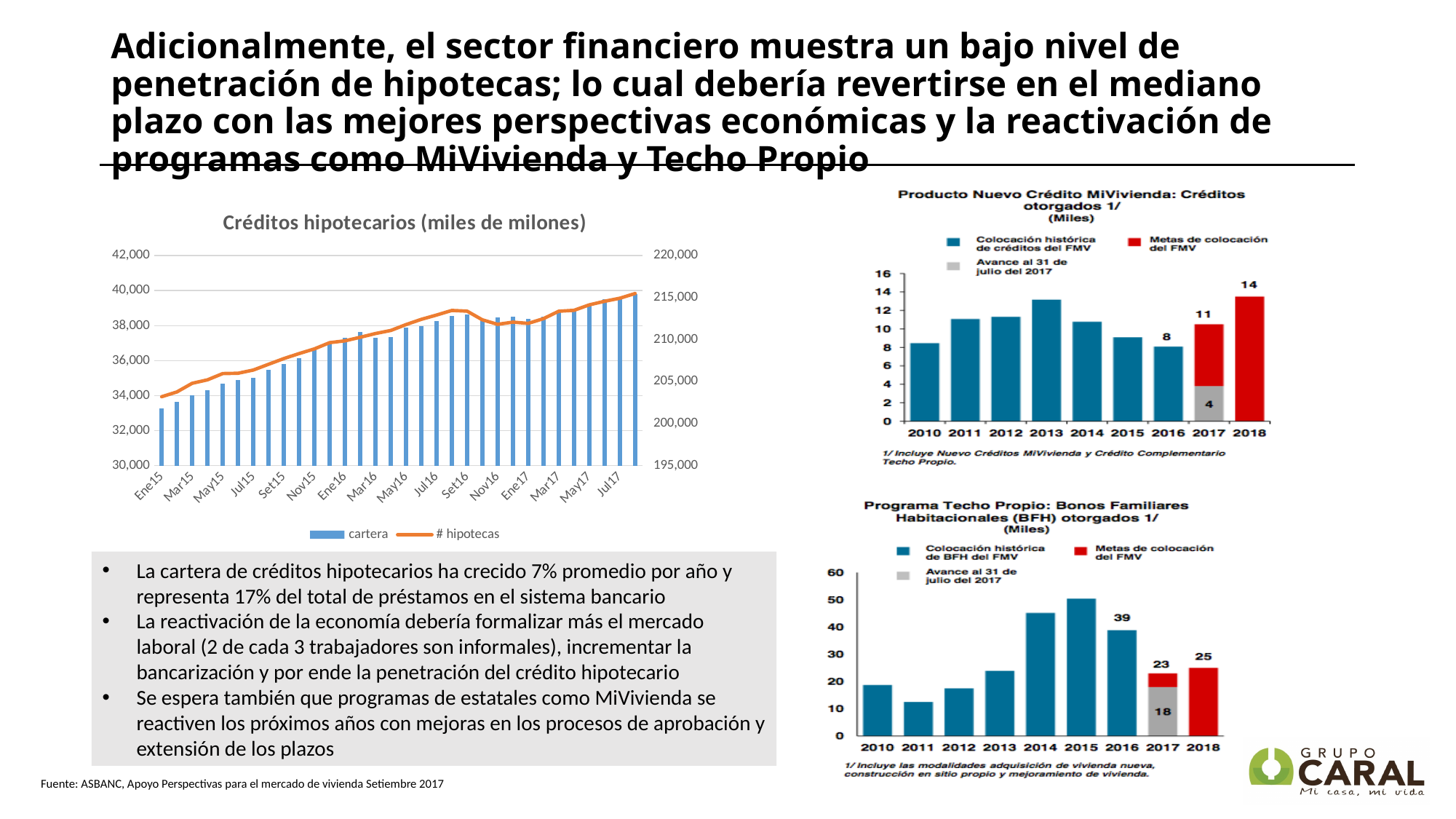
In the 'Producto Nuevo Crédito MiVivienda' chart, what is the difference between the 2018 value and the 2016 value? 6 In the 'Créditos hipotecarios (miles de milones)' chart, is the cartera value for Ene15 greater or less than 34,000? less In the 'Producto Nuevo Crédito MiVivienda' chart, what is the value for 2018? 14 In the 'Créditos hipotecarios (miles de milones)' chart, does the cartera series generally rise or fall from Ene15 to Jul17? rise In the 'Producto Nuevo Crédito MiVivienda' chart, what is the 'Avance al 31 de julio del 2017' value shown in the 2017 bar? 4 In the 'Producto Nuevo Crédito MiVivienda' chart, what is the value for 2016? 8 In the 'Créditos hipotecarios (miles de milones)' chart, what are the two legend entries? cartera and # hipotecas In the 'Programa Techo Propio' chart, what is the value for 2016? 39 In the 'Créditos hipotecarios (miles de milones)' chart, is the cartera value for Jul17 greater or less than 38,000? greater In the 'Programa Techo Propio' chart, which is larger, the value for 2017 or the value for 2018? 2018 In the 'Programa Techo Propio' chart, which year has the highest bar? 2015 In the 'Créditos hipotecarios (miles de milones)' chart, how many series does the legend list? 2